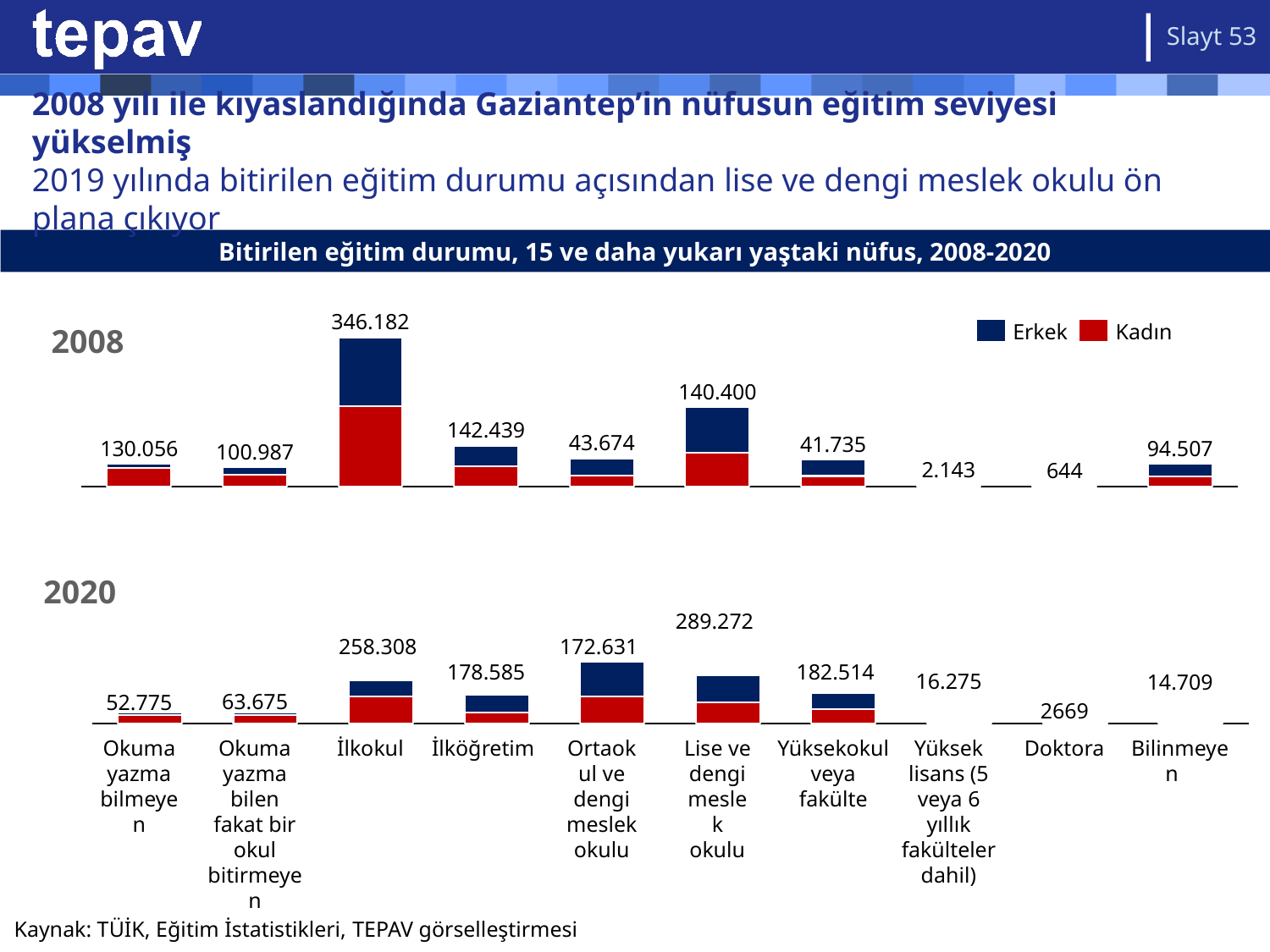
In the 2020 chart, which category has the highest total? Lise ve dengi meslek okulu In the 2008 chart, which category has the highest total? İlkokul In the 2020 chart, which is larger: the total for Yüksekokul veya fakülte or the total for İlköğretim? Yüksekokul veya fakülte What kind of chart is used for the 2008 data? Stacked bar chart In the 2008 chart, what is the difference between the totals for İlkokul and İlköğretim? 203.743 In the 2020 chart, which category has the lowest total? Doktora How many categories are shown along the x axis of the 2020 chart? 10 In the 2008 chart, what is the total labelled for İlkokul? 346.182 In the 2008 chart, which category has the lowest total? Doktora In the 2020 chart, what is the total labelled for Lise ve dengi meslek okulu? 289.272 In the 2020 chart, what is the total labelled for Doktora? 2669 How many series does the legend list? 2